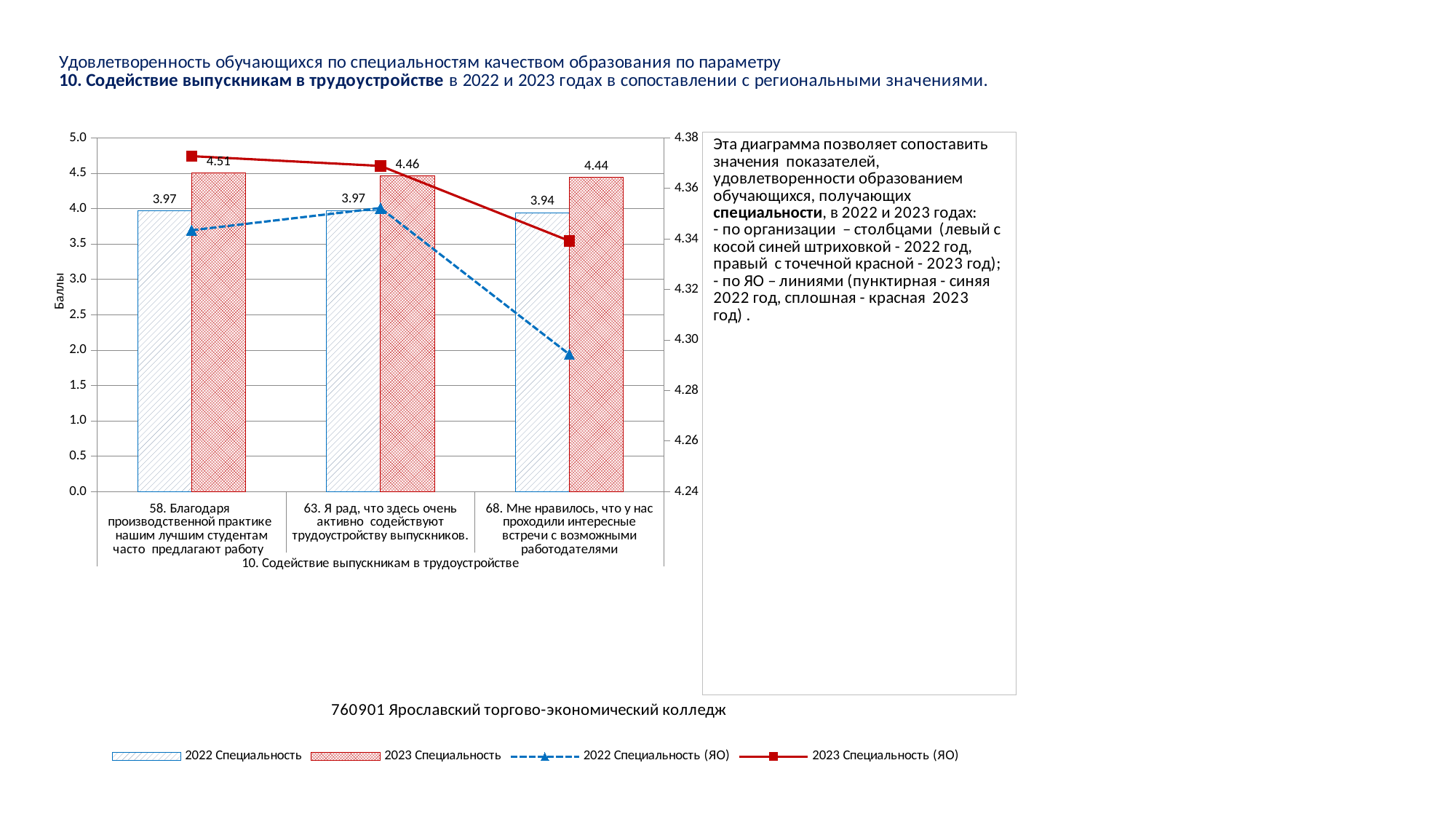
Which is larger for category 63: the 2022 Специальность bar or the 2023 Специальность bar? 2023 Специальность How many categories are shown on the x axis of the chart? 3 What is the value of the 2023 Специальность bar for category 68 (Мне нравилось, что у нас проходили интересные встречи с возможными работодателями)? 4.44 Is the value of the 2023 Специальность (ЯО) line for category 58 greater or less than 4.36 on the right axis? greater What is the value of the 2022 Специальность bar for category 58 (Благодаря производственной практике нашим лучшим студентам часто предлагают работу)? 3.97 What is the difference between the 2023 and 2022 Специальность bars for category 68? 0.50 Which category has the lowest 2022 Специальность bar? 68. Мне нравилось, что у нас проходили интересные встречи с возможными работодателями Which category has the highest 2023 Специальность bar? 58. Благодаря производственной практике нашим лучшим студентам часто предлагают работу How many series does the legend list? 4 What is the value of the 2023 Специальность bar for category 63 (Я рад, что здесь очень активно содействуют трудоустройству выпускников)? 4.46 Does the 2023 Специальность (ЯО) line rise or fall from category 58 to category 68? fall What is the difference between the 2023 and 2022 Специальность bars for category 58? 0.54